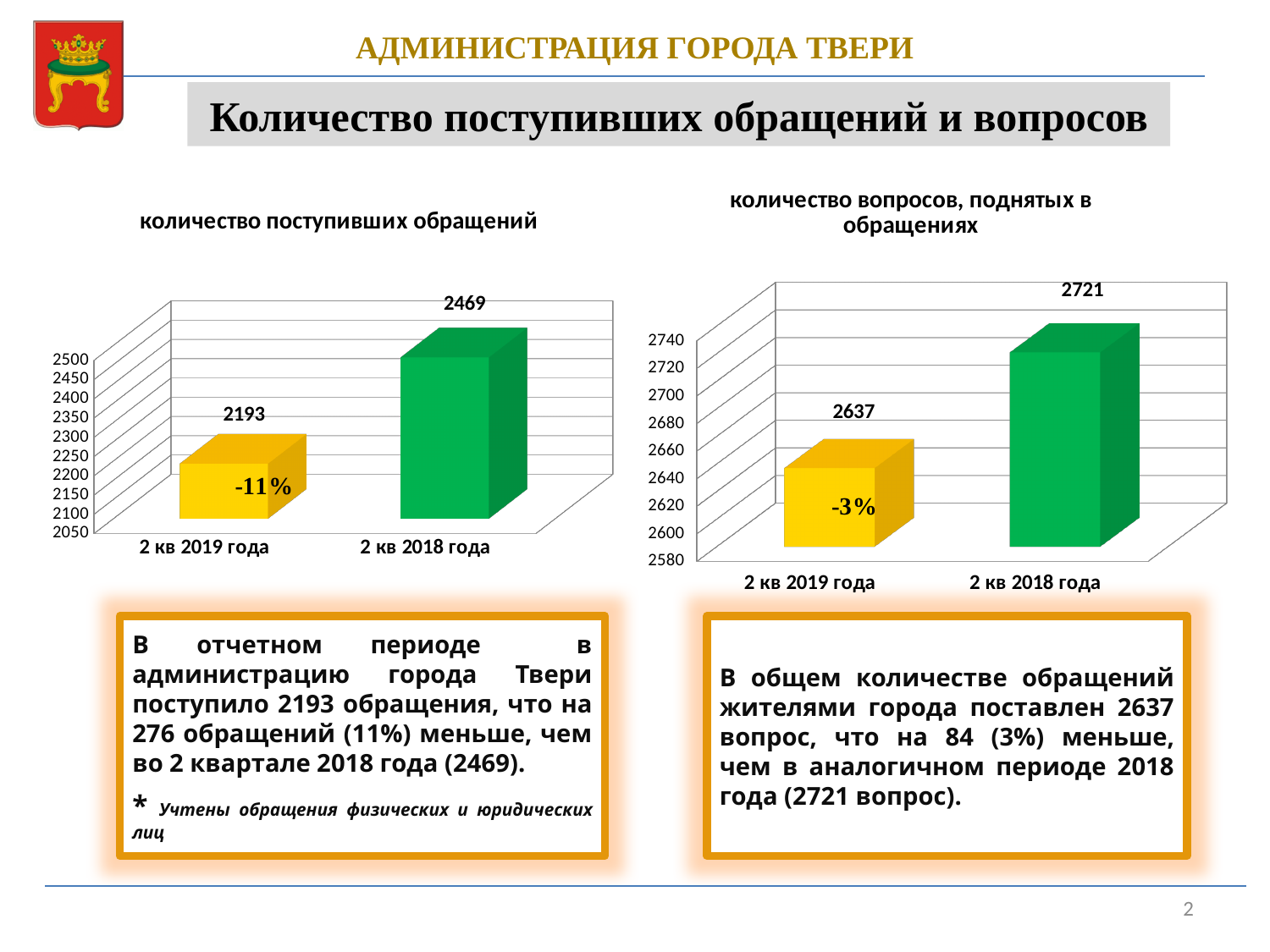
In the chart titled "количество вопросов, поднятых в обращениях", what is the value for 2 кв 2019 года? 2637 In the chart titled "количество вопросов, поднятых в обращениях", which category has the lowest value? 2 кв 2019 года In the chart titled "количество вопросов, поднятых в обращениях", what is the value for 2 кв 2018 года? 2721 In the chart titled "количество поступивших обращений", what is the value for 2 кв 2018 года? 2469 In the chart titled "количество поступивших обращений", what is the difference between the values for 2 кв 2018 года and 2 кв 2019 года? 276 What kind of chart is the chart titled "количество вопросов, поднятых в обращениях"? bar chart In the chart titled "количество вопросов, поднятых в обращениях", which is larger: the value for 2 кв 2019 года or 2 кв 2018 года? 2 кв 2018 года In the chart titled "количество поступивших обращений", which category has the highest value? 2 кв 2018 года In the chart titled "количество поступивших обращений", what is the value for 2 кв 2019 года? 2193 In the chart titled "количество вопросов, поднятых в обращениях", what is the difference between the values for 2 кв 2018 года and 2 кв 2019 года? 84 How many categories are shown in the chart titled "количество поступивших обращений"? 2 In the chart titled "количество поступивших обращений", what percentage change label is printed on the 2 кв 2019 года bar? -11%